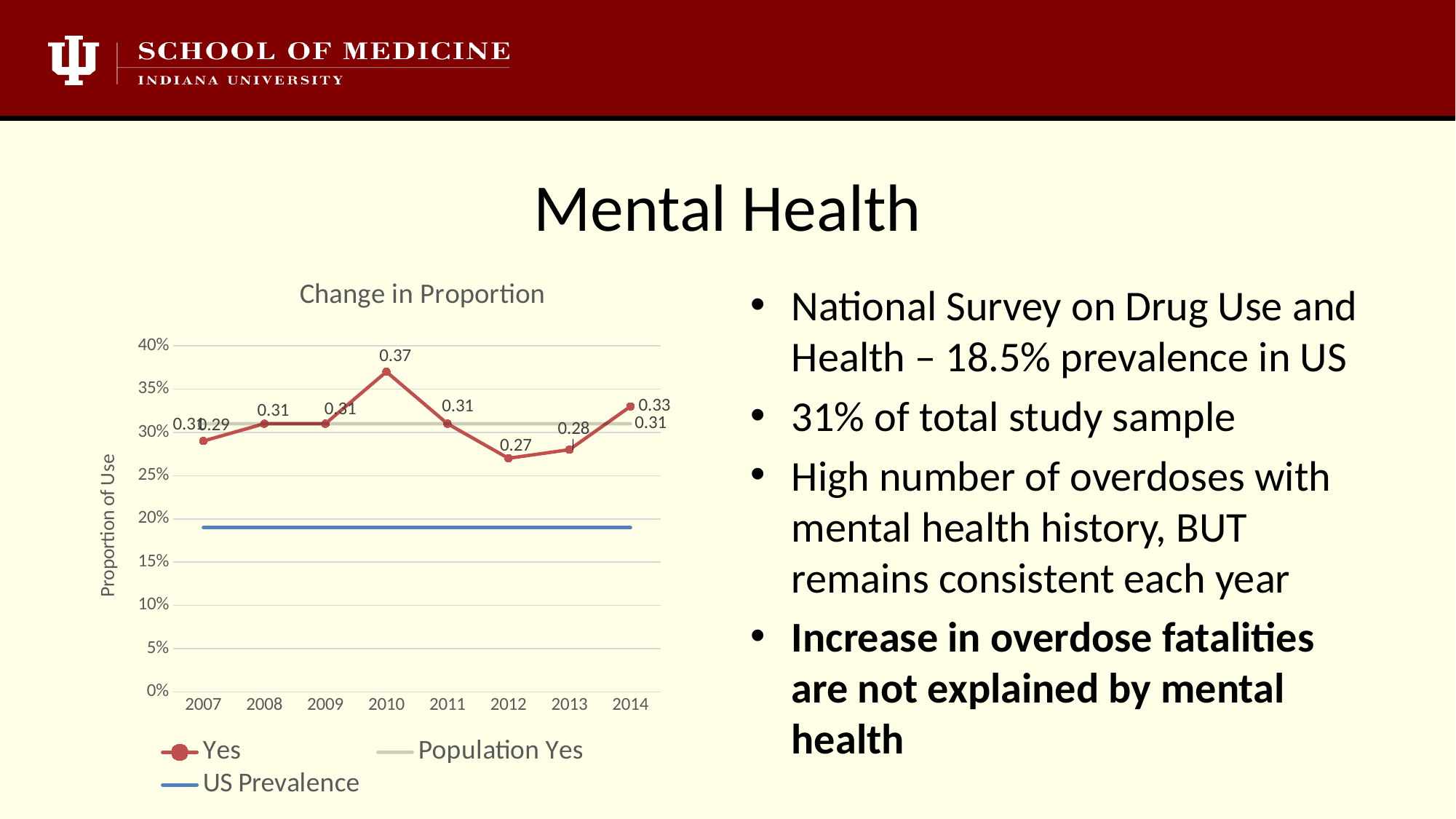
What is the value of the Yes series in 2014? 0.33 In which year is the Yes series highest? 2010 How many series does the chart legend list? 3 How many years are shown on the x axis of the chart? 8 Which is larger, the Yes value in 2007 or the Yes value in 2014? 2014 What is the value of the Yes series in 2012? 0.27 What is the difference between the Yes value in 2010 and the Yes value in 2012? 0.10 In which year is the Yes series lowest? 2012 What type of chart is shown on the slide? line chart Is the value of the US Prevalence line greater or less than 20%? less What is the title of the chart? Change in Proportion What is the value of the Yes series in 2010? 0.37